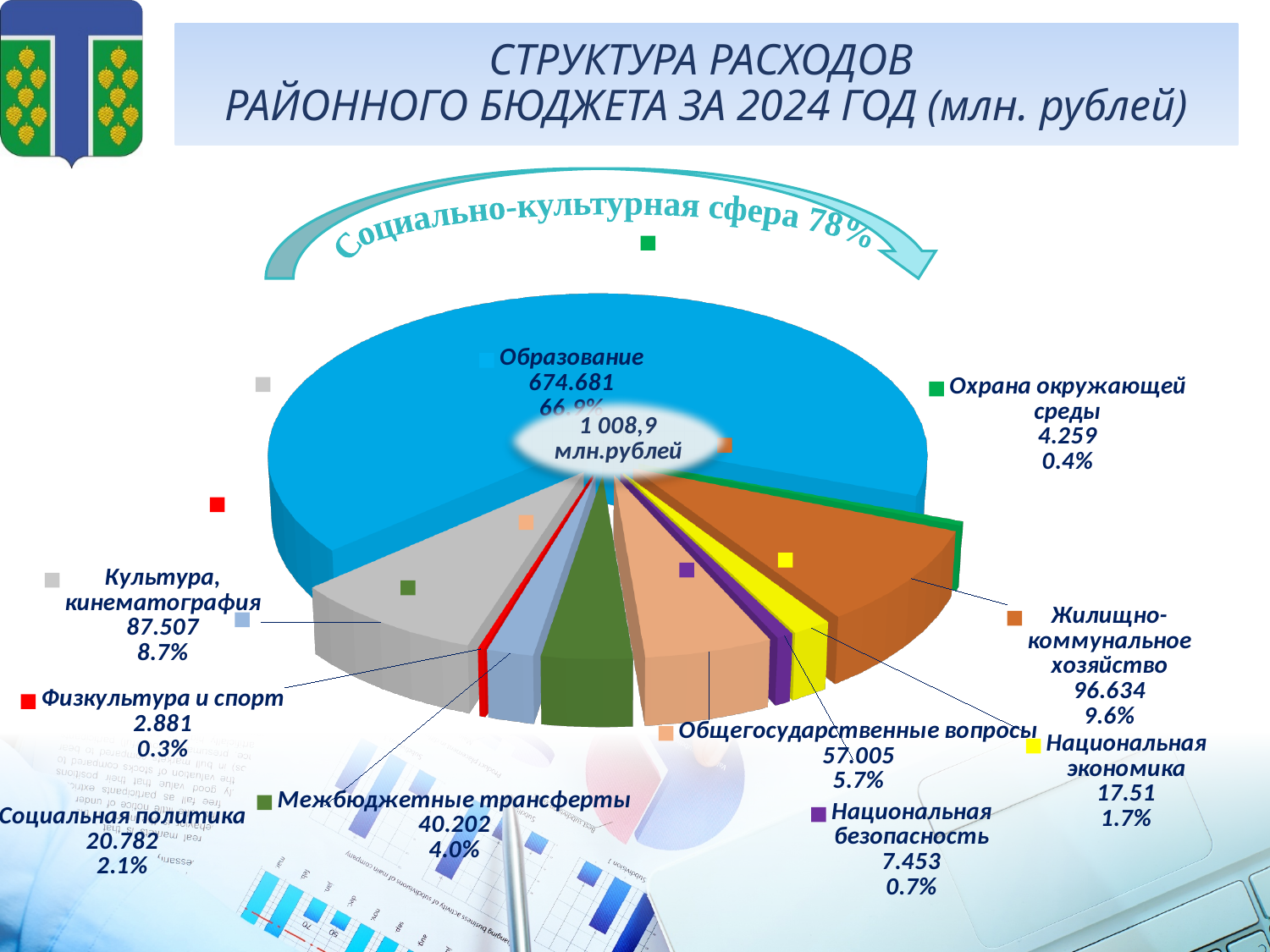
What share of the pie does Культура, кинематография take? 8.7% What is the value for Жилищно-коммунальное хозяйство? 96.634 What share of the pie does Национальная безопасность take? 0.7% Which category has the smallest slice of the pie? Физкультура и спорт How many categories are shown in the pie chart? 10 What kind of chart is shown on the slide? pie chart What total is shown in the centre of the pie chart? 1 008,9 млн.рублей What percentage is given for Социально-культурная сфера in the arrow above the chart? 78% Which category has the largest slice of the pie? Образование Which is larger, the value for Общегосударственные вопросы or the value for Межбюджетные трансферты? Общегосударственные вопросы What is the value for Образование? 674.681 What is the difference between the values for Жилищно-коммунальное хозяйство and Культура, кинематография? 9.127